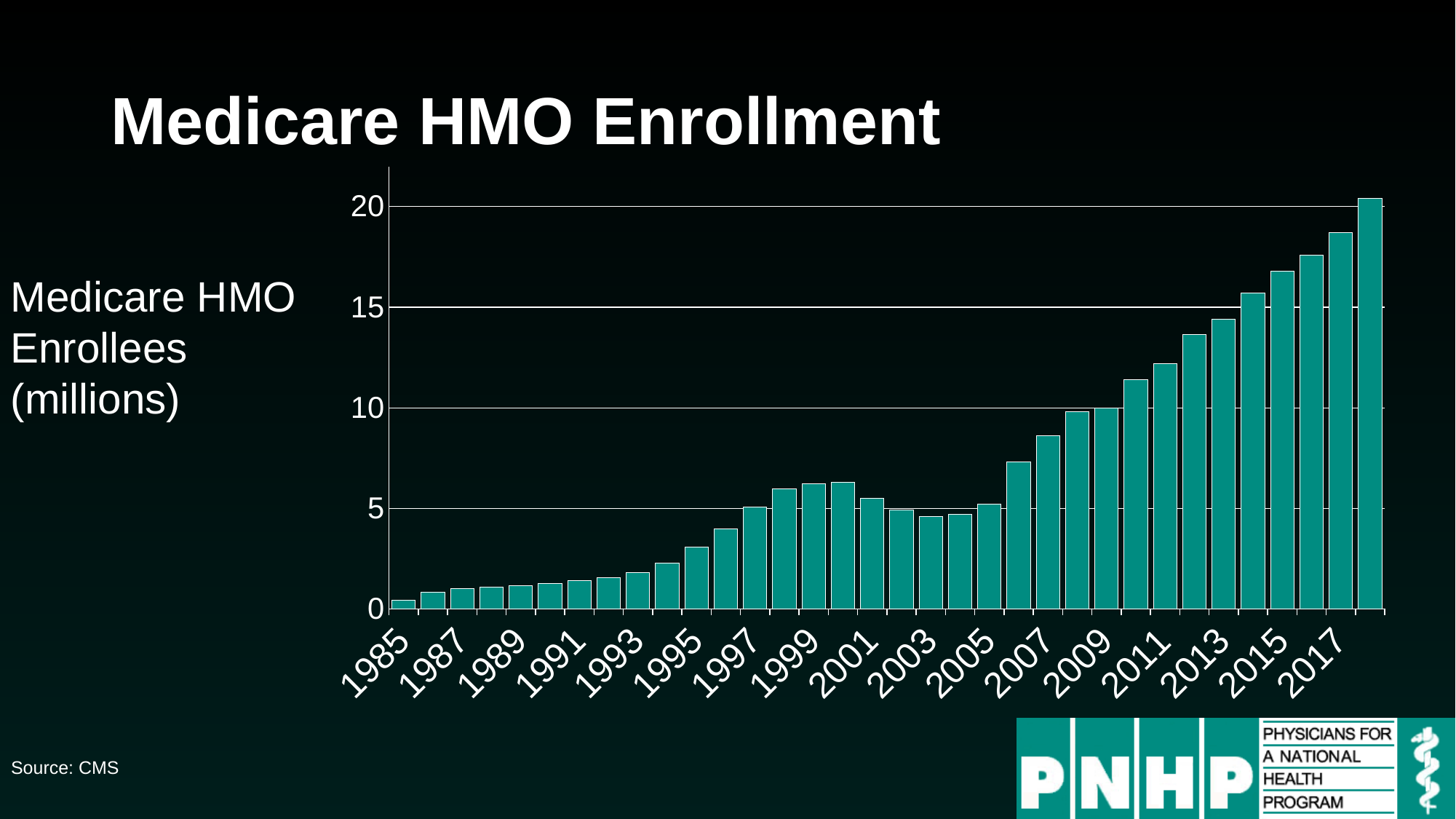
Is the value for 2013 greater or less than 15? less What is the title of the chart? Medicare HMO Enrollment What quantity does the vertical axis of the chart represent? Medicare HMO Enrollees (millions) Which year has the lowest Medicare HMO enrollment in the chart? 1985 Overall, do the values rise or fall from 1985 to the end of the chart? rise Is the value for 2017 greater or less than 15? greater Which year has the larger value, 1999 or 2003? 1999 Which year has the larger value, 2017 or 2007? 2017 What kind of chart is shown on the slide? bar chart Is the value for 1995 greater or less than 5? less